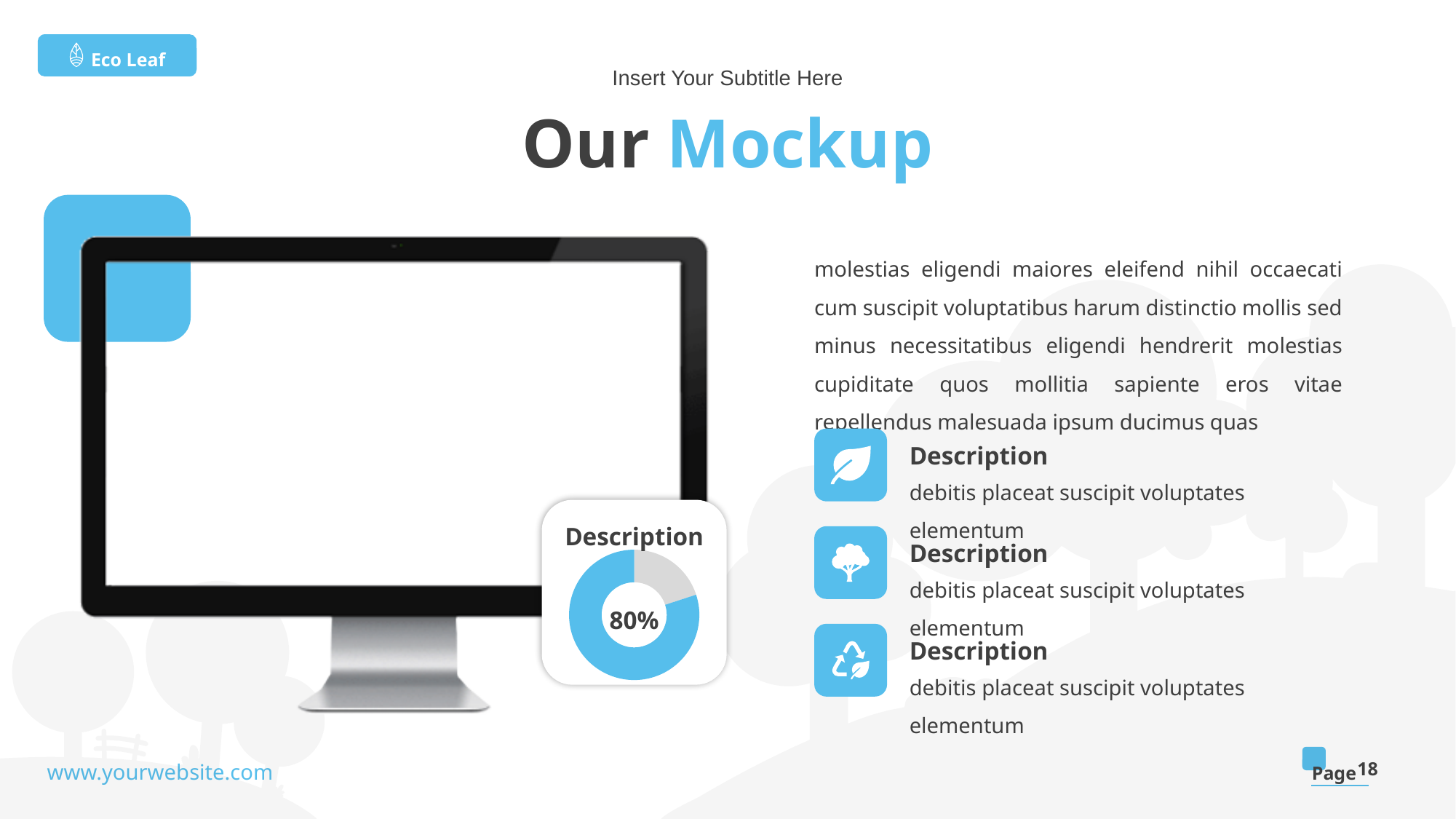
What share of the donut chart does the grey slice represent? 20% Is the grey slice of the donut chart greater or less than 50% of the whole? less Is the blue slice of the donut chart greater or less than 50% of the whole? greater What percentage is printed in the centre of the donut chart? 80% What colour is the largest slice of the donut chart? Blue How many slices does the donut chart have? 2 What kind of chart is shown on the slide? Donut chart What is the title shown above the donut chart? Description Which slice of the donut chart is larger, the blue one or the grey one? Blue What share of the donut chart does the blue slice represent? 80%